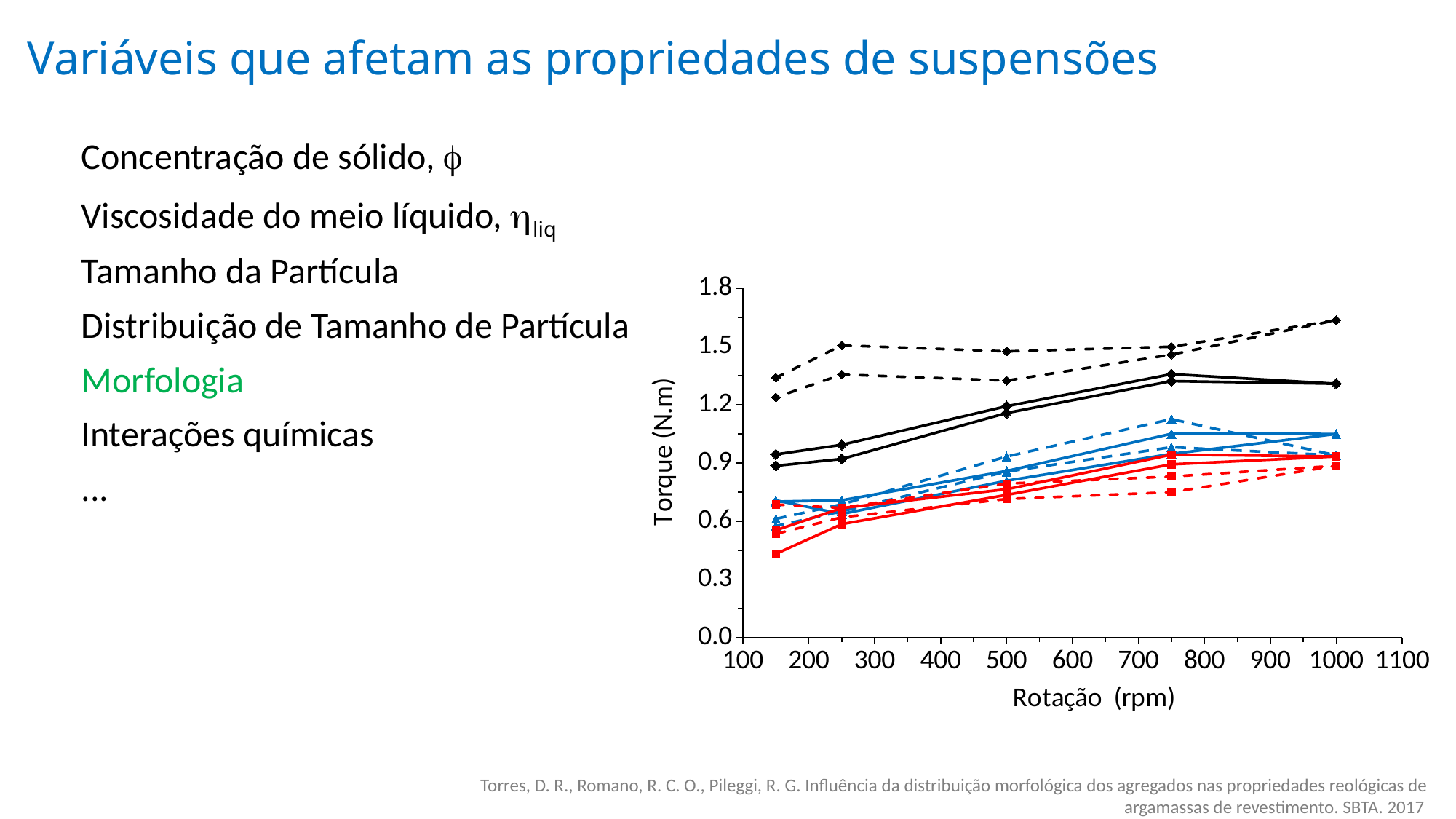
Do the red solid lines generally rise or fall as rotation increases from 150 to 1000 rpm? rise How many rotation values (data points) are plotted for each line? 5 What is the title of the horizontal axis of the chart? Rotação (rpm) Which colour of lines shows the highest torque values across the chart? black Are the values of the black solid lines at 150 rpm greater or less than 1.2? less Which colour of lines shows the lowest torque value at 150 rpm? red Is the value of the topmost black dashed line at 1000 rpm greater or less than 1.5? greater Is the value of the lowest red solid line at 150 rpm greater or less than 0.6? less At 1000 rpm, which is larger: the torque of the black lines or the torque of the red lines? black lines What kind of chart is shown on the slide? line chart What is the title of the vertical axis of the chart? Torque (N.m)